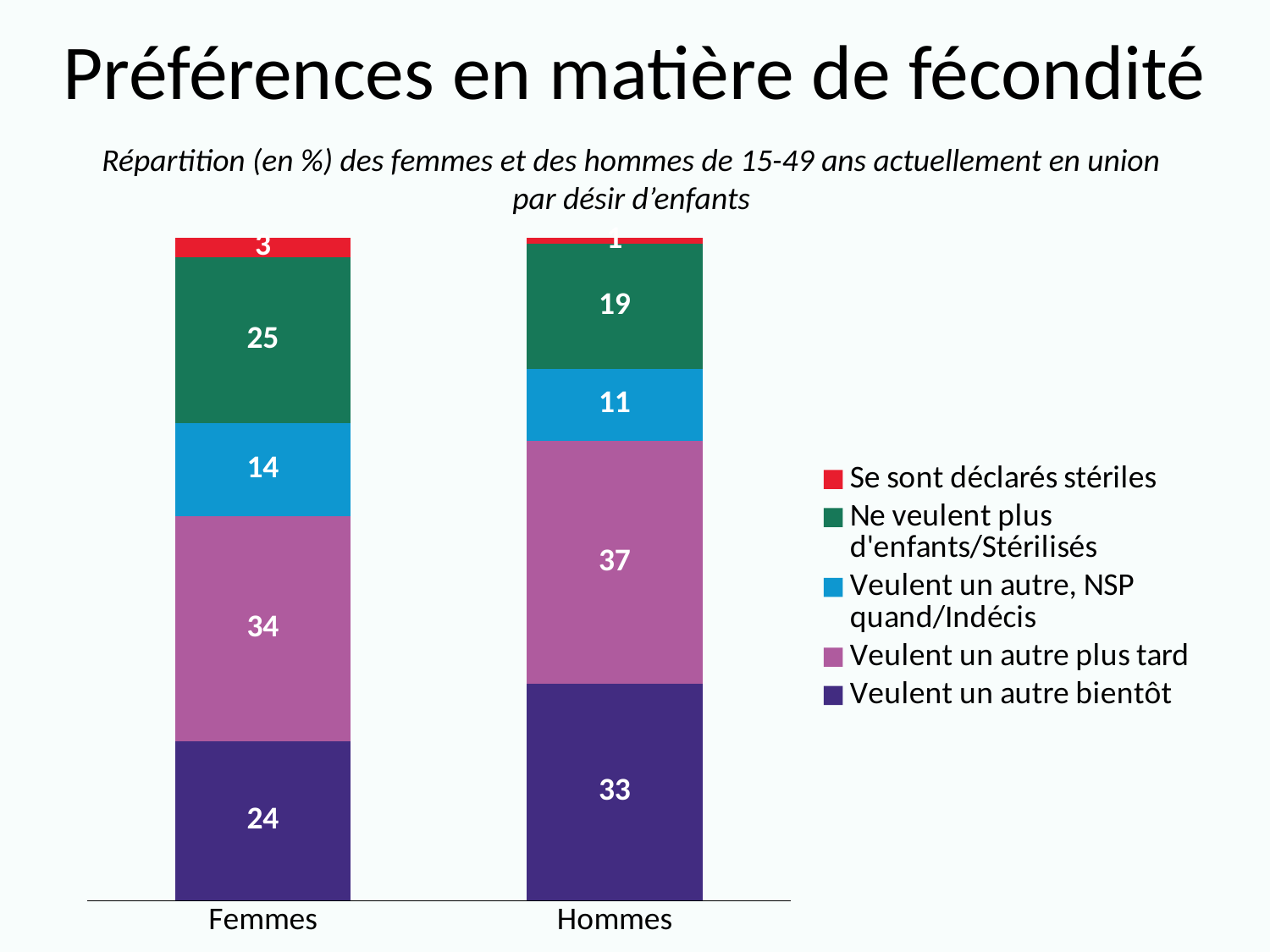
How many series does the chart legend list? 5 What is the total of the Femmes stacked bar? 100 What is the value for 'Veulent un autre bientôt' for Femmes? 24 What is the value for 'Veulent un autre, NSP quand/Indécis' for Femmes? 14 Which is larger, 'Veulent un autre bientôt' for Femmes or for Hommes? Hommes What is the value for 'Se sont déclarés stériles' for Femmes? 3 Which segment is the largest in the Femmes bar? Veulent un autre plus tard What is the value for 'Veulent un autre plus tard' for Hommes? 37 What is the difference between 'Ne veulent plus d'enfants/Stérilisés' for Femmes and for Hommes? 6 What kind of chart is shown on the slide? Stacked bar chart How many categories are shown on the x axis of the chart? 2 What is the value for 'Ne veulent plus d'enfants/Stérilisés' for Hommes? 19